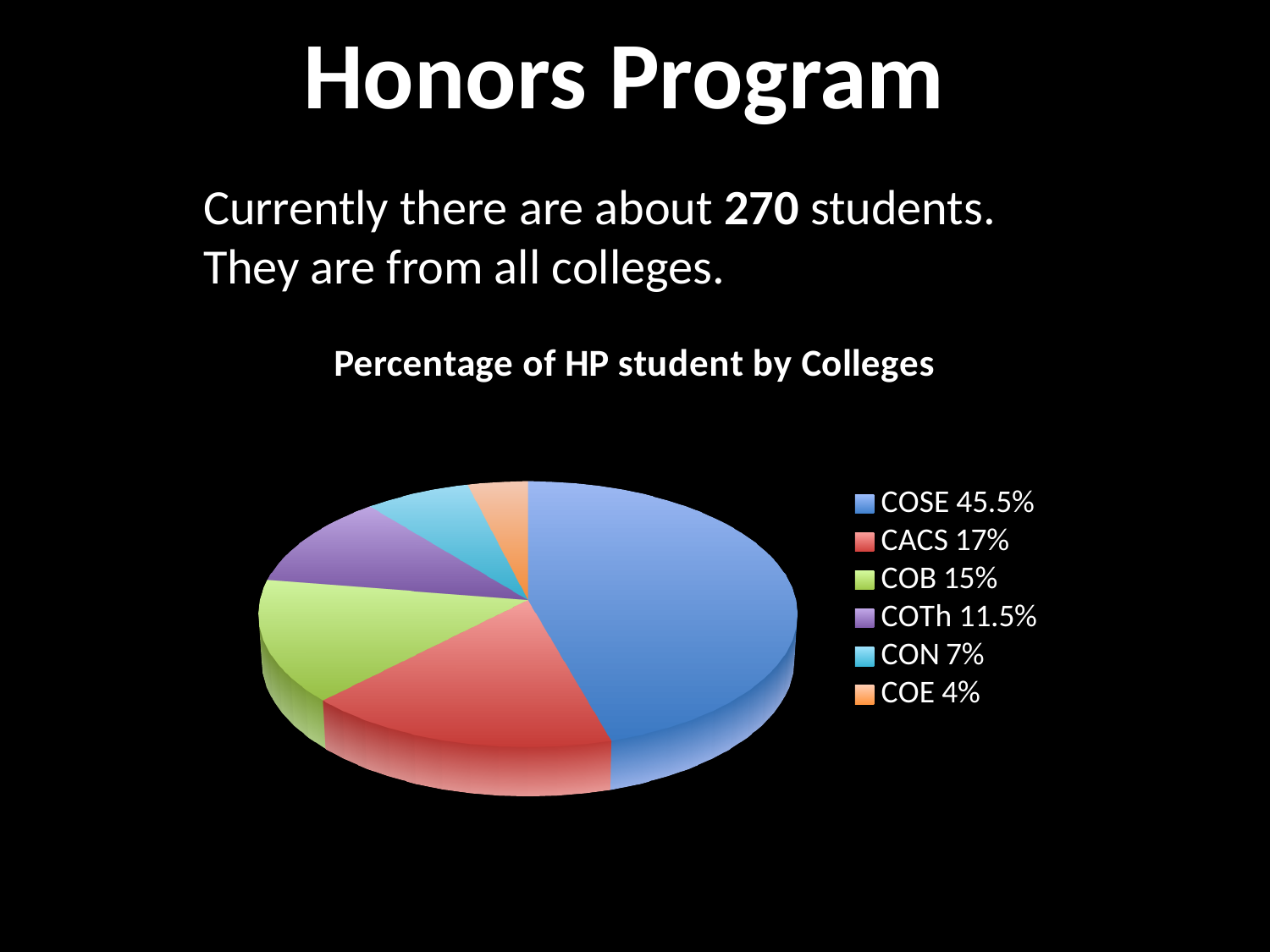
What colour is the COB slice in the pie chart? green How many colleges are shown in the pie chart? 6 What is the title of the chart? Percentage of HP student by Colleges Which college has the smallest share of HP students? COE What percentage of HP students are from COTh? 11.5% What type of chart is shown on the slide? pie chart What percentage of HP students are from CACS? 17% What percentage of HP students are from COE? 4% Which college has the largest share of HP students? COSE What percentage of HP students are from COSE? 45.5% Which has a larger share of HP students, COB or CON? COB What is the difference between the COSE share and the CACS share? 28.5%